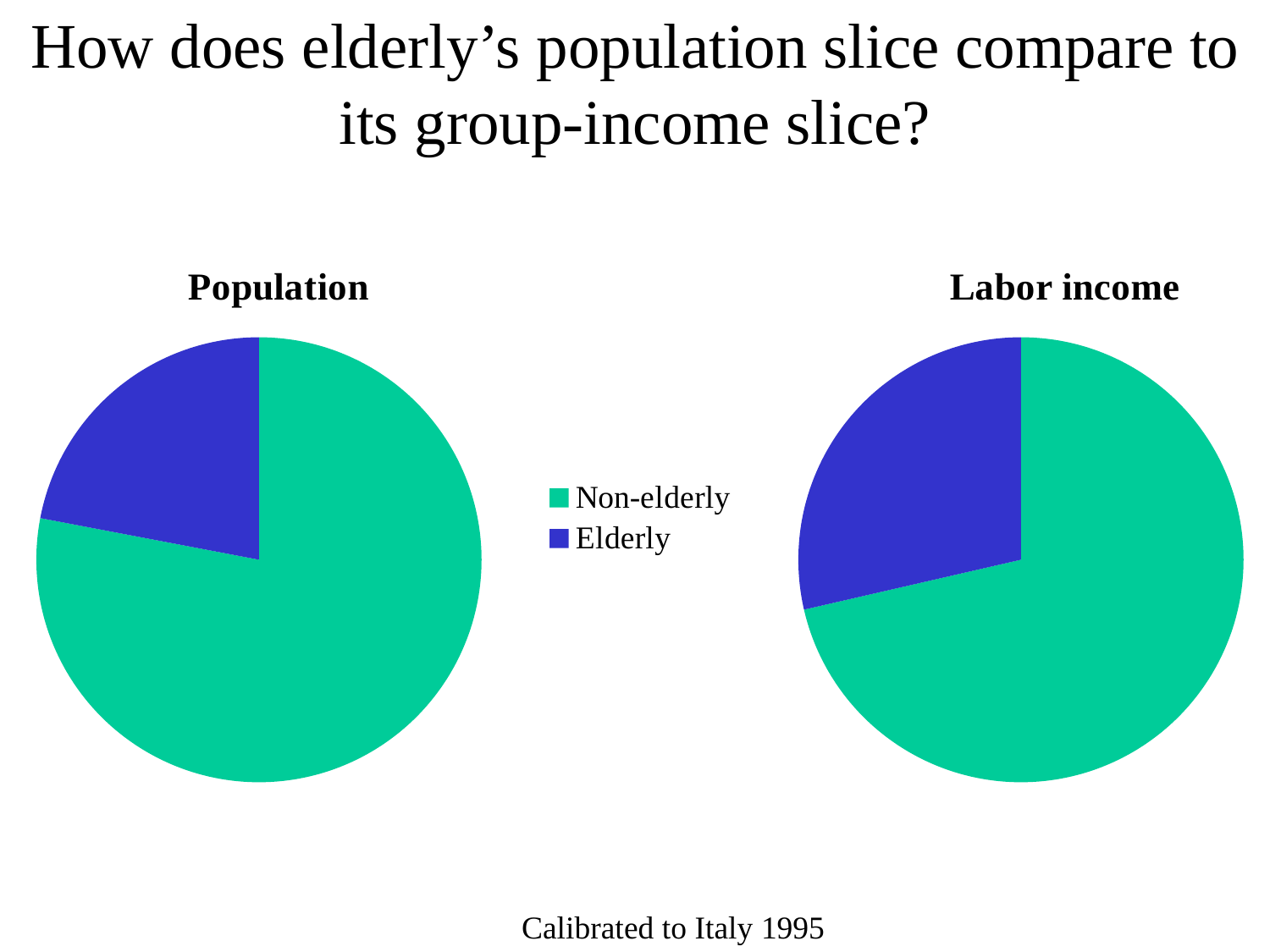
How many entries does the legend list? 2 In the Labor income chart, is the Non-elderly slice larger or smaller than the Elderly slice? larger What colour is the Elderly slice in the pie charts? blue In the Labor income chart, which slice is the largest? Non-elderly What kind of chart is the Labor income chart? pie chart In the Population chart, which slice is the largest? Non-elderly In the Labor income chart, which slice is the smallest? Elderly How many slices does the Labor income pie chart have? 2 How many slices does the Population pie chart have? 2 What kind of chart is the Population chart? pie chart What is the title of the pie chart on the right? Labor income In the Population chart, which slice is the smallest? Elderly